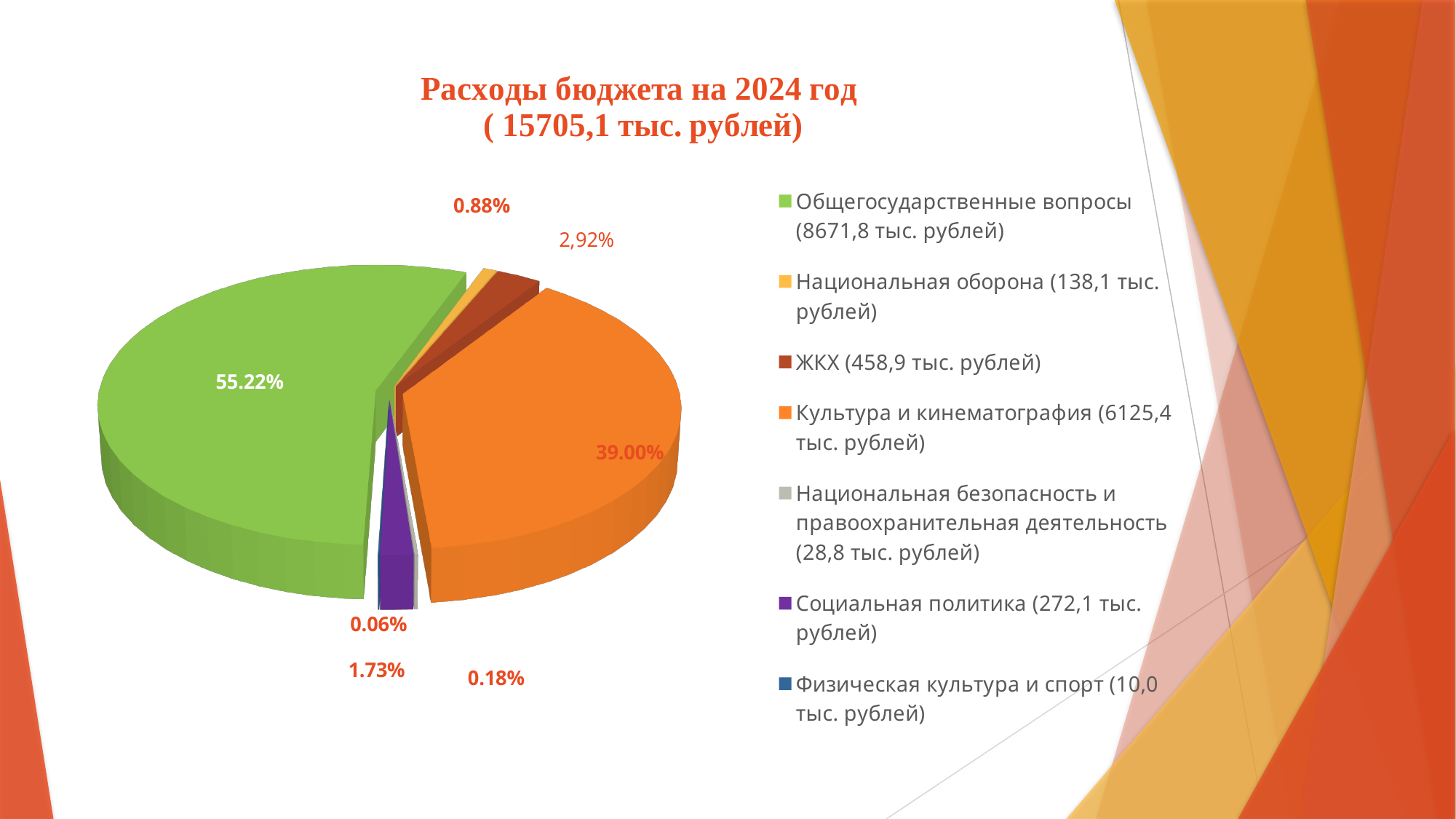
What share of the pie does ЖКХ take? 2,92% Which category has the smallest slice of the pie? Физическая культура и спорт What share of the pie does Культура и кинематография take? 39.00% Which category has the largest slice of the pie? Общегосударственные вопросы What kind of chart is shown on the slide? pie chart What share of the pie does Общегосударственные вопросы take? 55.22% According to the legend, what is the amount for Культура и кинематография? 6125,4 тыс. рублей What is the title of the chart? Расходы бюджета на 2024 год ( 15705,1 тыс. рублей) Which is larger, the share for Социальная политика or the share for ЖКХ? ЖКХ How many categories does the legend list? 7